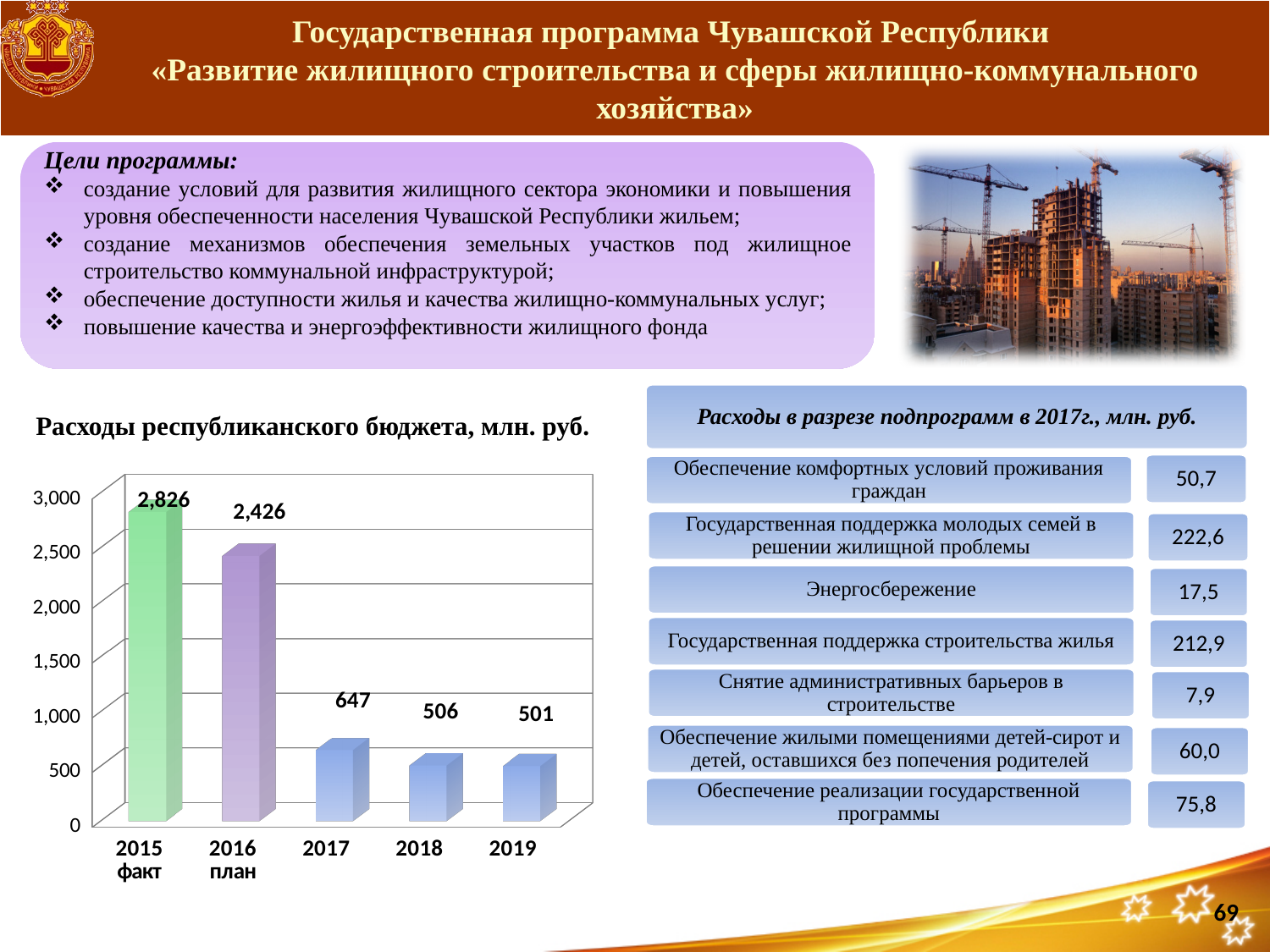
What is the value for 2016 план in the chart 'Расходы республиканского бюджета, млн. руб.'? 2,426 What is the difference between the values for 2015 факт and 2016 план in the chart 'Расходы республиканского бюджета, млн. руб.'? 400 Which category has the lowest value in the chart 'Расходы республиканского бюджета, млн. руб.'? 2019 Which is larger in the chart 'Расходы республиканского бюджета, млн. руб.': the value for 2016 план or the value for 2017? 2016 план Do the values in the chart 'Расходы республиканского бюджета, млн. руб.' rise or fall from 2015 факт to 2019? Fall What is the value for 2017 in the chart 'Расходы республиканского бюджета, млн. руб.'? 647 How many categories are shown on the x axis of the chart 'Расходы республиканского бюджета, млн. руб.'? 5 What is the difference between the values for 2017 and 2018 in the chart 'Расходы республиканского бюджета, млн. руб.'? 141 What kind of chart is 'Расходы республиканского бюджета, млн. руб.'? Bar chart What is the value for 2015 факт in the chart 'Расходы республиканского бюджета, млн. руб.'? 2,826 Which category has the highest value in the chart 'Расходы республиканского бюджета, млн. руб.'? 2015 факт What is the value for 2019 in the chart 'Расходы республиканского бюджета, млн. руб.'? 501